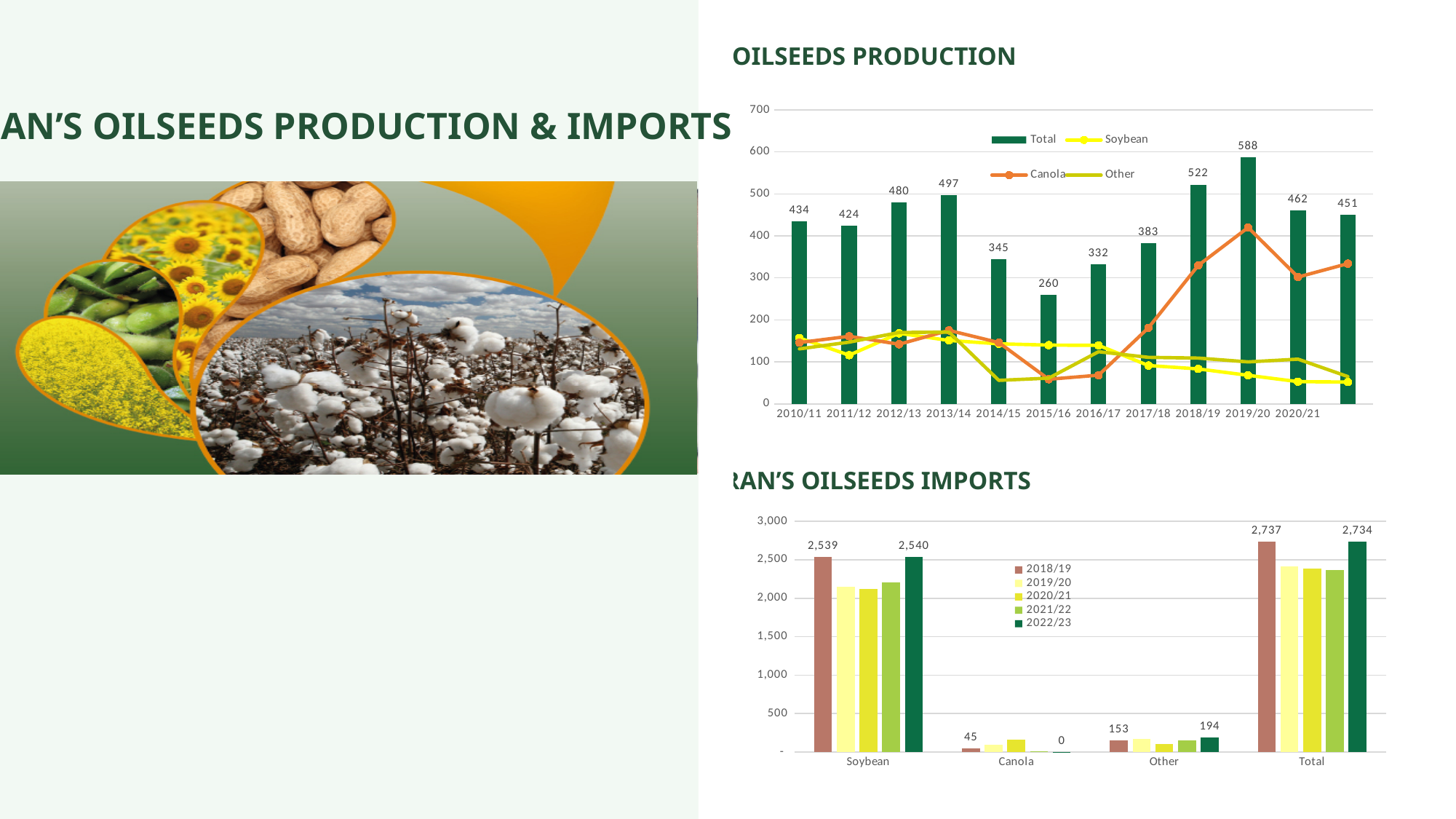
In the OILSEEDS IMPORTS chart, what is the Soybean import value for 2022/23? 2,540 In the OILSEEDS PRODUCTION chart, which year has the lowest Total production? 2015/16 How many categories are shown on the x axis of the OILSEEDS IMPORTS chart? 4 How many series does the legend of the OILSEEDS IMPORTS chart list? 5 In the OILSEEDS PRODUCTION chart, what is the Total production value for 2019/20? 588 In the OILSEEDS IMPORTS chart, what is the Total import value for 2018/19? 2,737 In the OILSEEDS IMPORTS chart, what is the difference between the Other imports in 2022/23 and 2018/19? 41 In the OILSEEDS PRODUCTION chart, what is the Total production value for 2012/13? 480 In the OILSEEDS PRODUCTION chart, which year has the highest Total production? 2019/20 In the OILSEEDS PRODUCTION chart, is the Canola value for 2015/16 greater or less than 100? less In the OILSEEDS PRODUCTION chart, what is the difference between the Total production in 2013/14 and 2014/15? 152 How many series does the legend of the OILSEEDS PRODUCTION chart list? 4